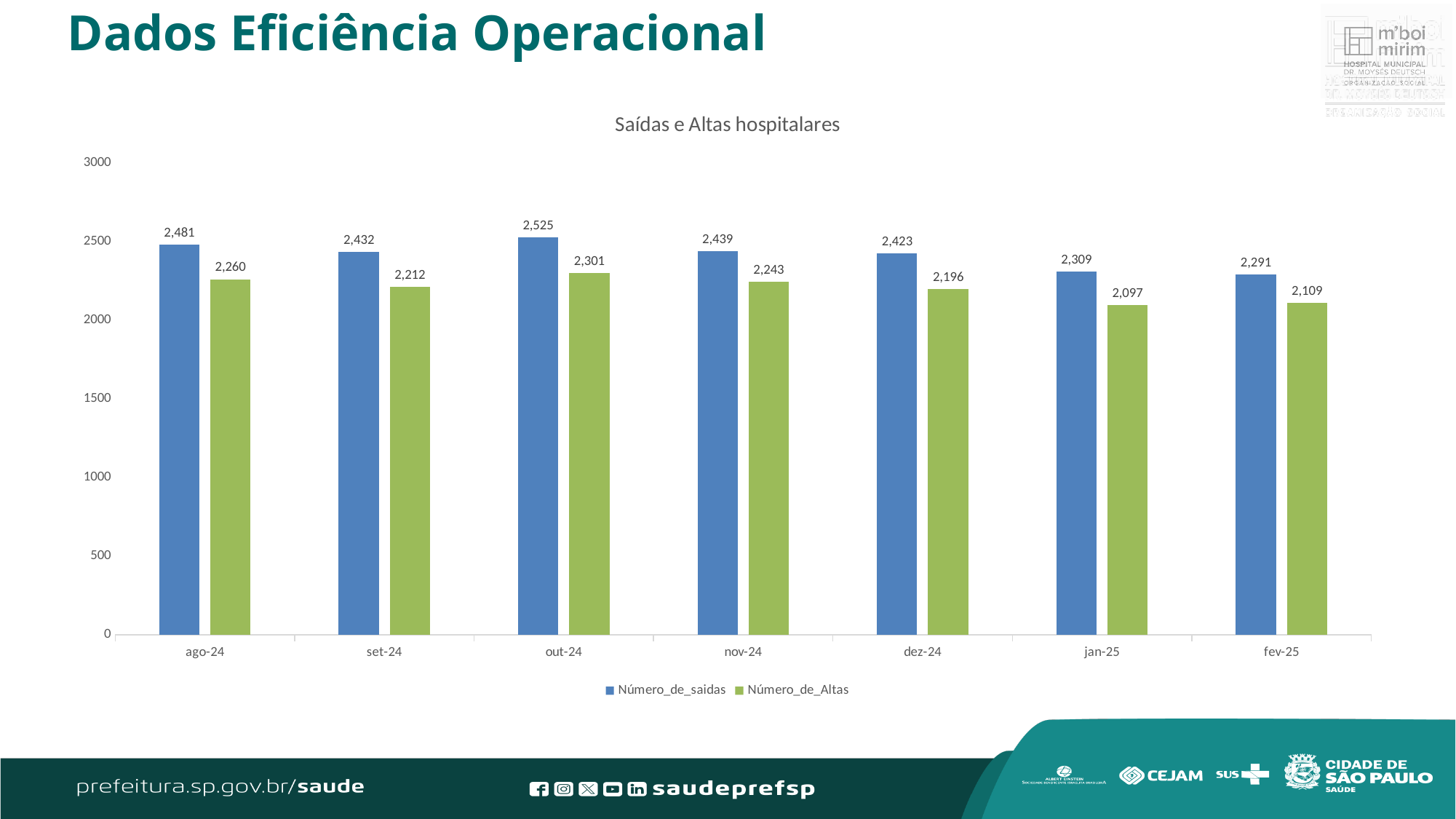
How many months are shown on the x axis? 7 Is the value of Número_de_saidas for fev-25 greater or less than 2000? greater What kind of chart is shown on the slide? bar chart What is the value of Número_de_Altas for jan-25? 2,097 Which month has the highest Número_de_saidas? out-24 Which is larger: Número_de_Altas in set-24 or Número_de_Altas in nov-24? Número_de_Altas in nov-24 What is the difference between Número_de_saidas and Número_de_Altas in ago-24? 221 What is the title of the chart? Saídas e Altas hospitalares Does Número_de_Altas rise or fall from out-24 to jan-25? fall What is the value of Número_de_saidas for out-24? 2,525 How many series does the legend list? 2 Which month has the lowest Número_de_Altas? jan-25